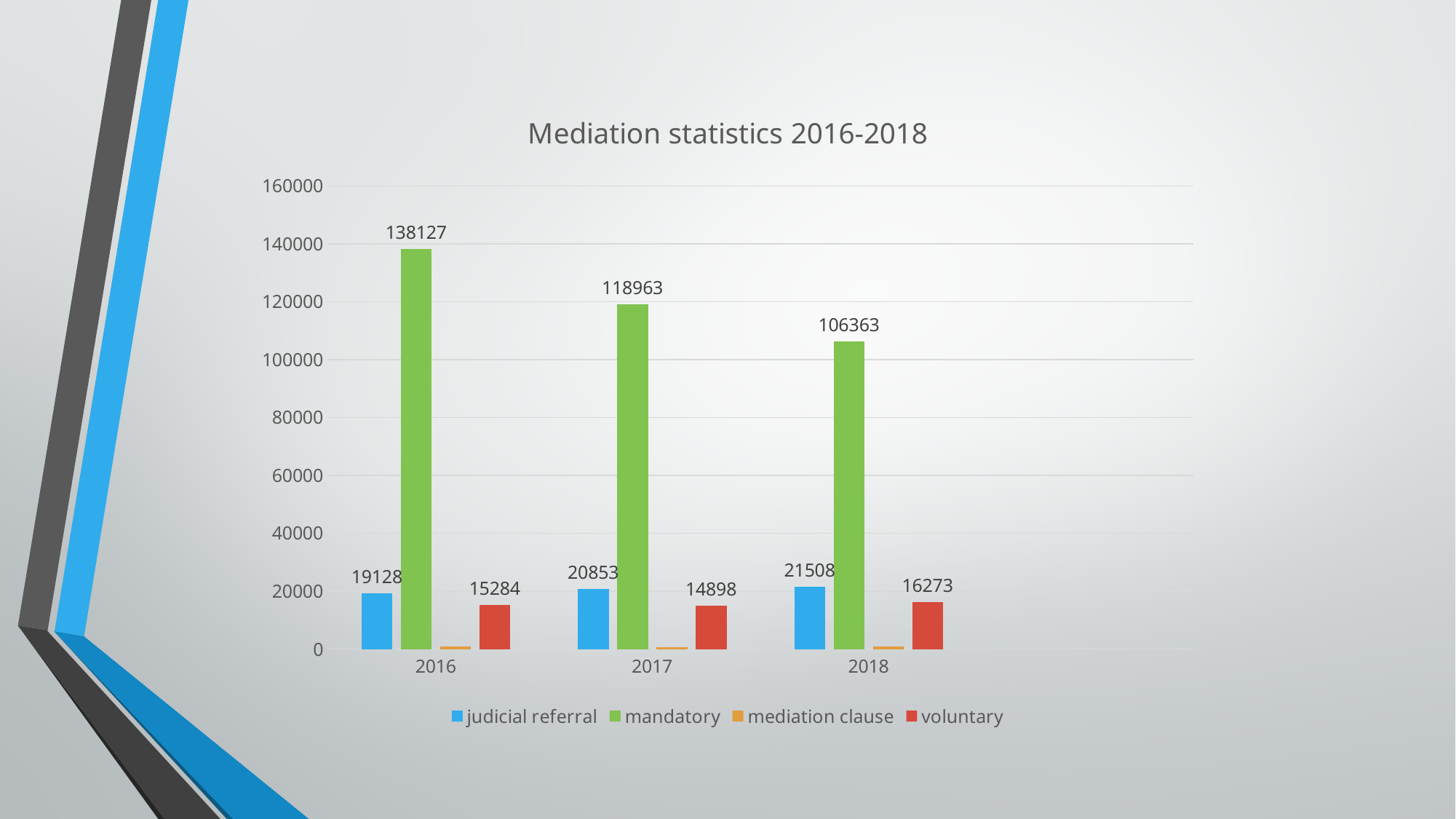
In which year is the mandatory value highest? 2016 Is the value for mediation clause in 2016 greater or less than 20000? less How many years are shown on the x axis? 3 What is the value for judicial referral in 2018? 21508 Do the mandatory values rise or fall from 2016 to 2018? fall Which is larger in 2018: judicial referral or voluntary? judicial referral What is the value for voluntary in 2017? 14898 In which year is the voluntary value lowest? 2017 How many series does the legend list? 4 What is the difference between the mandatory values for 2016 and 2017? 19164 What is the value for mandatory in 2016? 138127 What kind of chart is shown on the slide? bar chart